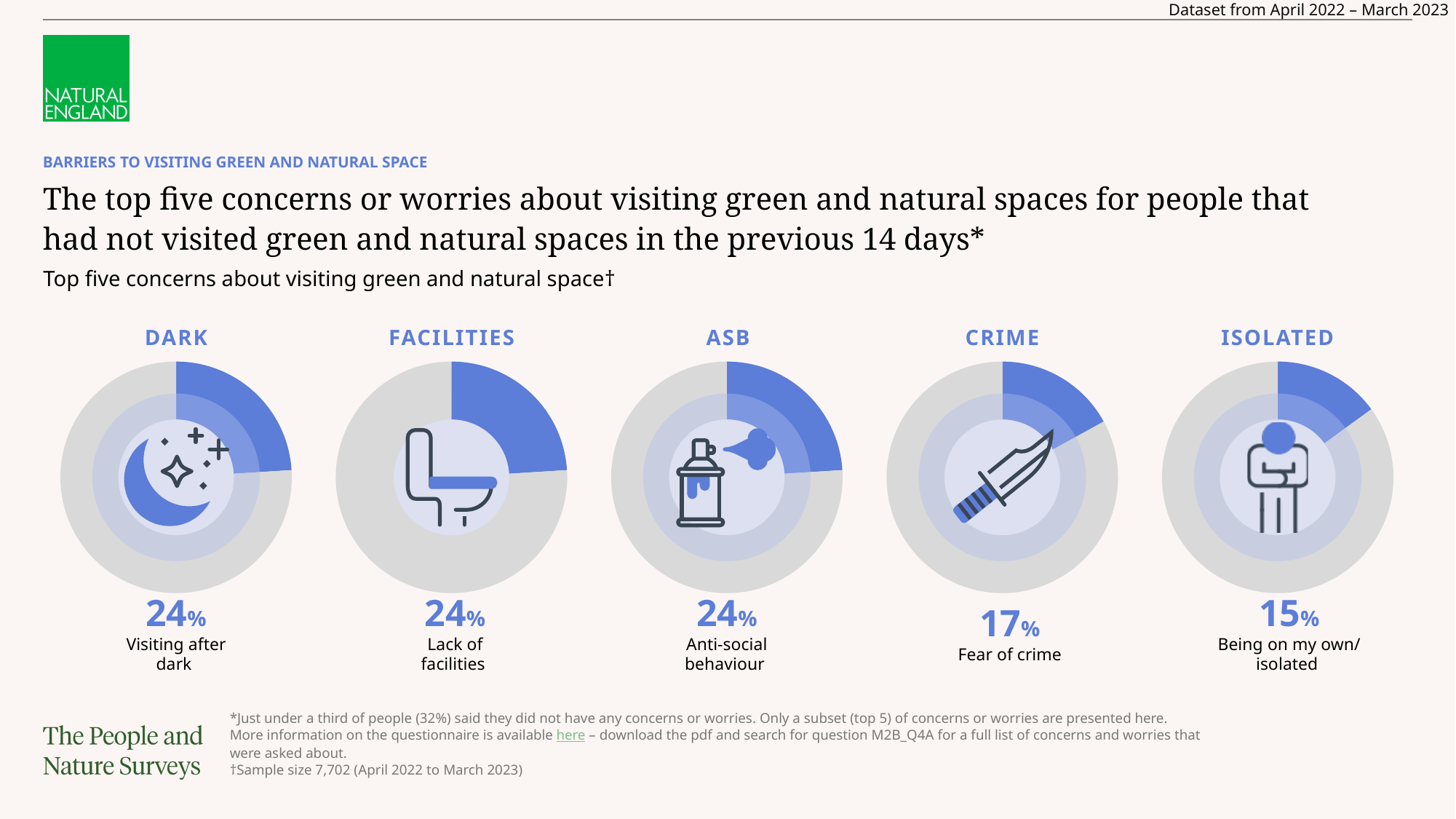
What percentage of people cited visiting after dark as a concern? 24% Which of the five concerns has the lowest percentage? Isolated (Being on my own/isolated) What kind of chart is used to show each concern? Pie (donut) chart What is the difference in percentage points between the value for anti-social behaviour and the value for being on my own/isolated? 9 percentage points What is the difference between the value for visiting after dark and the value for fear of crime? 7 percentage points What percentage is shown for being on my own/isolated? 15% Which is larger, the value for fear of crime or the value for being on my own/isolated? Fear of crime What value is shown for lack of facilities? 24% How many of the five concerns share the same value of 24%? 3 What is the value shown for the CRIME chart (fear of crime)? 17% How many concerns are shown as charts on the slide? 5 What is the heading above the chart showing the knife icon? CRIME